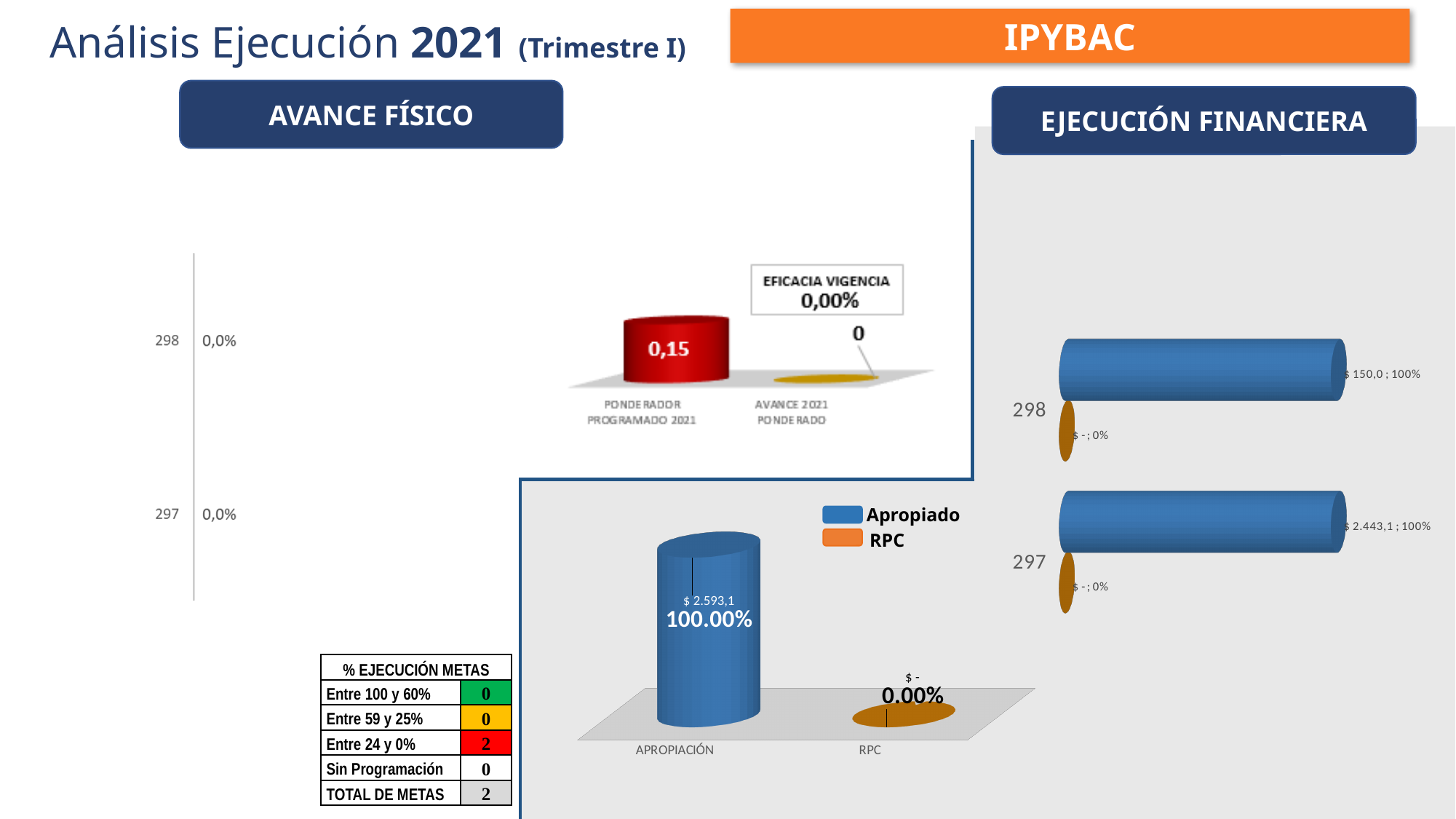
In the left-hand chart under AVANCE FÍSICO, what value is shown for category 298? 0,0% In the bottom-centre chart with categories APROPIACIÓN and RPC, what value is labelled on the APROPIACIÓN bar? $ 2.593,1 In the chart with categories PONDERADOR PROGRAMADO 2021 and AVANCE 2021 PONDERADO, what is the value for PONDERADOR PROGRAMADO 2021? 0,15 In the chart with categories PONDERADOR PROGRAMADO 2021 and AVANCE 2021 PONDERADO, what is the value for AVANCE 2021 PONDERADO? 0 What are the legend entries of the bottom-centre chart with categories APROPIACIÓN and RPC? Apropiado, RPC In the right-hand horizontal bar chart under EJECUCIÓN FINANCIERA, what is the label on the blue bar for category 297? $ 2.443,1 ; 100% In the right-hand horizontal bar chart under EJECUCIÓN FINANCIERA, how many categories are shown? 2 How many series does the legend of the bottom-centre chart (APROPIACIÓN and RPC) list? 2 In the right-hand horizontal bar chart under EJECUCIÓN FINANCIERA, what is the label on the blue bar for category 298? $ 150,0 ; 100% In the chart with categories PONDERADOR PROGRAMADO 2021 and AVANCE 2021 PONDERADO, what EFICACIA VIGENCIA percentage is shown? 0,00% In the bottom-centre chart with categories APROPIACIÓN and RPC, what percentage is shown for RPC? 0.00% In the bottom-centre chart with categories APROPIACIÓN and RPC, which category has the higher value? APROPIACIÓN